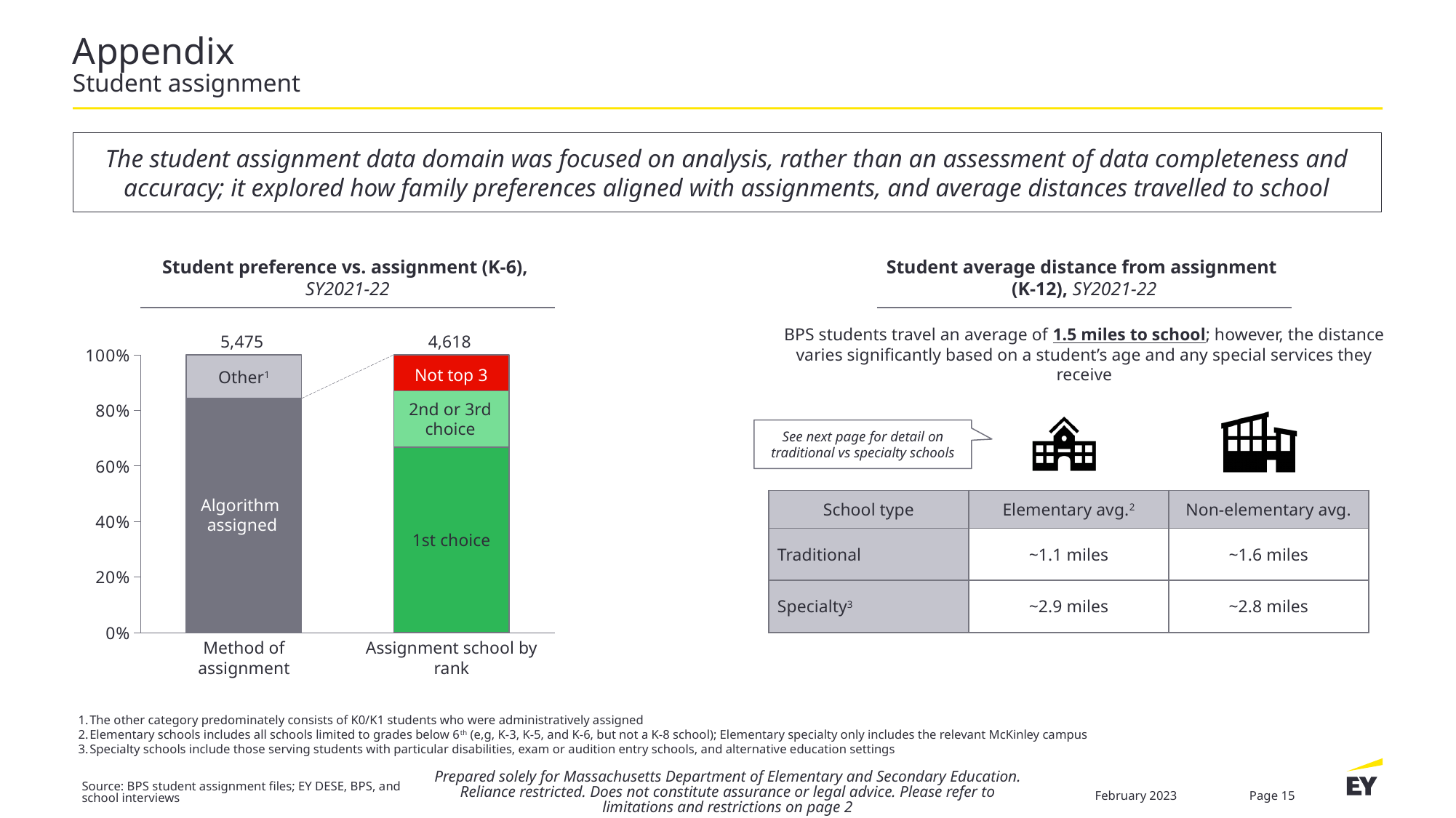
What type of chart is shown under the title "Student preference vs. assignment (K-6)"? Stacked bar chart In the "Student preference vs. assignment (K-6)" chart, how many segments make up the "Assignment school by rank" bar? 3 In the "Student preference vs. assignment (K-6)" chart, what is the difference between the printed totals of the two bars? 857 In the "Student preference vs. assignment (K-6)" chart, is the "Algorithm assigned" share of the "Method of assignment" bar greater or less than 80%? greater In the "Student preference vs. assignment (K-6)" chart, what total is printed above the "Assignment school by rank" bar? 4,618 In the "Student preference vs. assignment (K-6)" chart, what total is printed above the "Method of assignment" bar? 5,475 In the "Student preference vs. assignment (K-6)" chart, is the "1st choice" share of the "Assignment school by rank" bar greater or less than 60%? greater In the "Student preference vs. assignment (K-6)" chart, what school year is given in the chart title? SY2021-22 In the "Student preference vs. assignment (K-6)" chart, is the "Not top 3" share of the "Assignment school by rank" bar greater or less than 20%? less In the "Student preference vs. assignment (K-6)" chart, which bar has the larger printed total, "Method of assignment" or "Assignment school by rank"? Method of assignment How many bars are shown in the "Student preference vs. assignment (K-6)" chart? 2 In the "Student preference vs. assignment (K-6)" chart, which segment of the "Assignment school by rank" bar is the largest? 1st choice